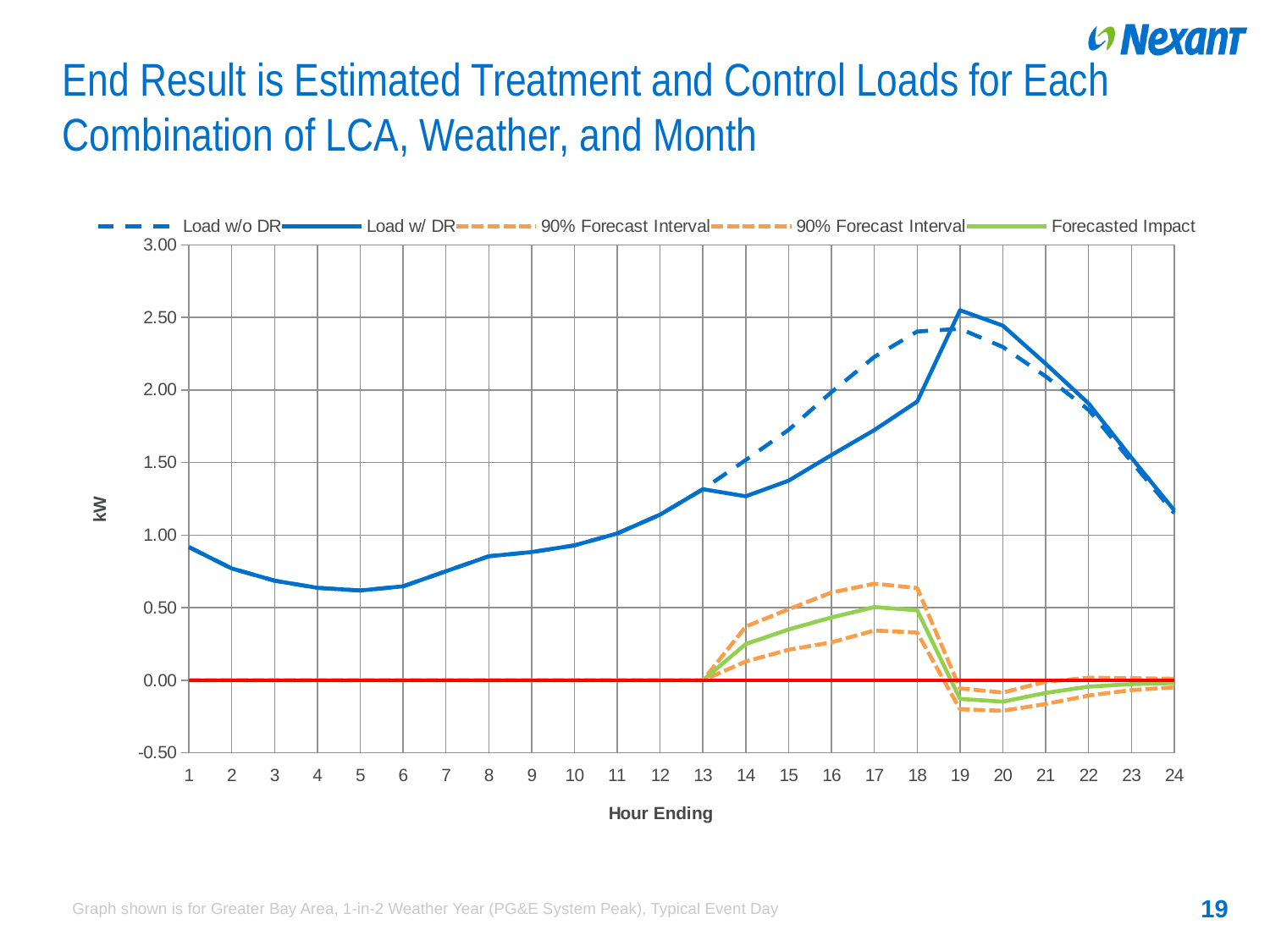
At hour ending 16, which is larger: Load w/o DR or Load w/ DR? Load w/o DR Is the value of Load w/ DR at hour ending 1 greater or less than 1.00? less How many hours are shown along the x axis? 24 Does the Load w/ DR series rise or fall from hour ending 19 to hour ending 24? fall What is the label on the y axis of the chart? kW Is the value of Forecasted Impact at hour ending 19 greater or less than 0.00? less At hour ending 19, which is larger: Load w/ DR or Load w/o DR? Load w/ DR At which hour ending does the Load w/ DR series reach its lowest value? 5 What kind of chart is shown on the slide? line chart At which hour ending does the Load w/ DR series reach its highest value? 19 How many series does the legend list? 5 Is the value of Load w/o DR at hour ending 18 greater or less than 2.00? greater